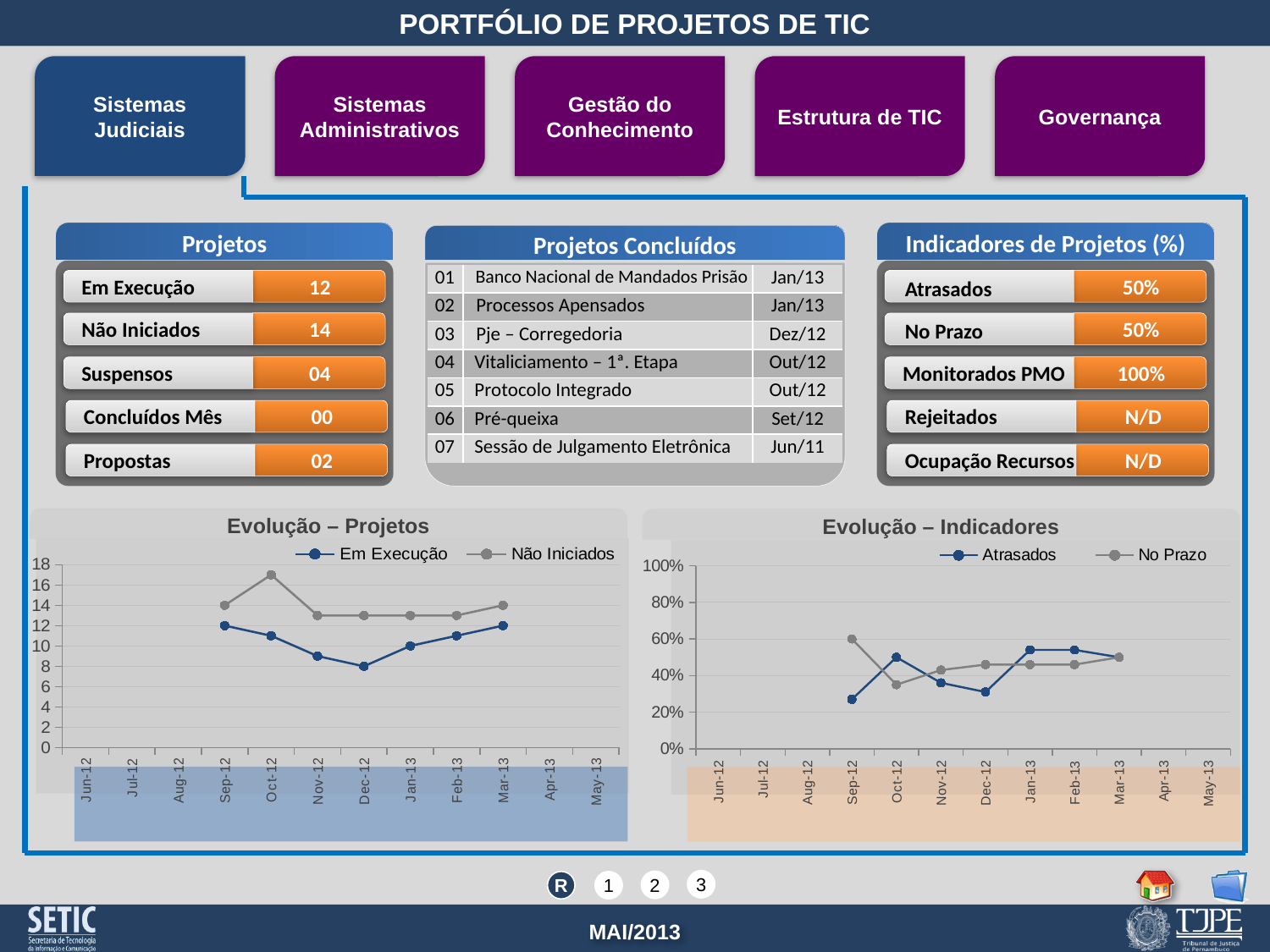
What type of chart is "Evolução – Projetos"? Line chart How many series does the legend of "Evolução – Indicadores" list? 2 In "Evolução – Indicadores", is the value for Atrasados in Sep-12 greater or less than 40%? less In "Evolução – Projetos", what is the value of Não Iniciados in Sep-12? 14 In "Evolução – Projetos", which series has the larger value in Mar-13, Em Execução or Não Iniciados? Não Iniciados In "Evolução – Projetos", what is the value of Em Execução in Dec-12? 8 In "Evolução – Projetos", in which month is Em Execução lowest? Dec-12 In "Evolução – Indicadores", what is the value of No Prazo in Sep-12? 60% In "Evolução – Projetos", in which month is Não Iniciados highest? Oct-12 In "Evolução – Projetos", does Em Execução rise or fall from Dec-12 to Mar-13? Rise In "Evolução – Projetos", what is the value of Em Execução in Mar-13? 12 In "Evolução – Projetos", what is the difference between Não Iniciados and Em Execução in Sep-12? 2